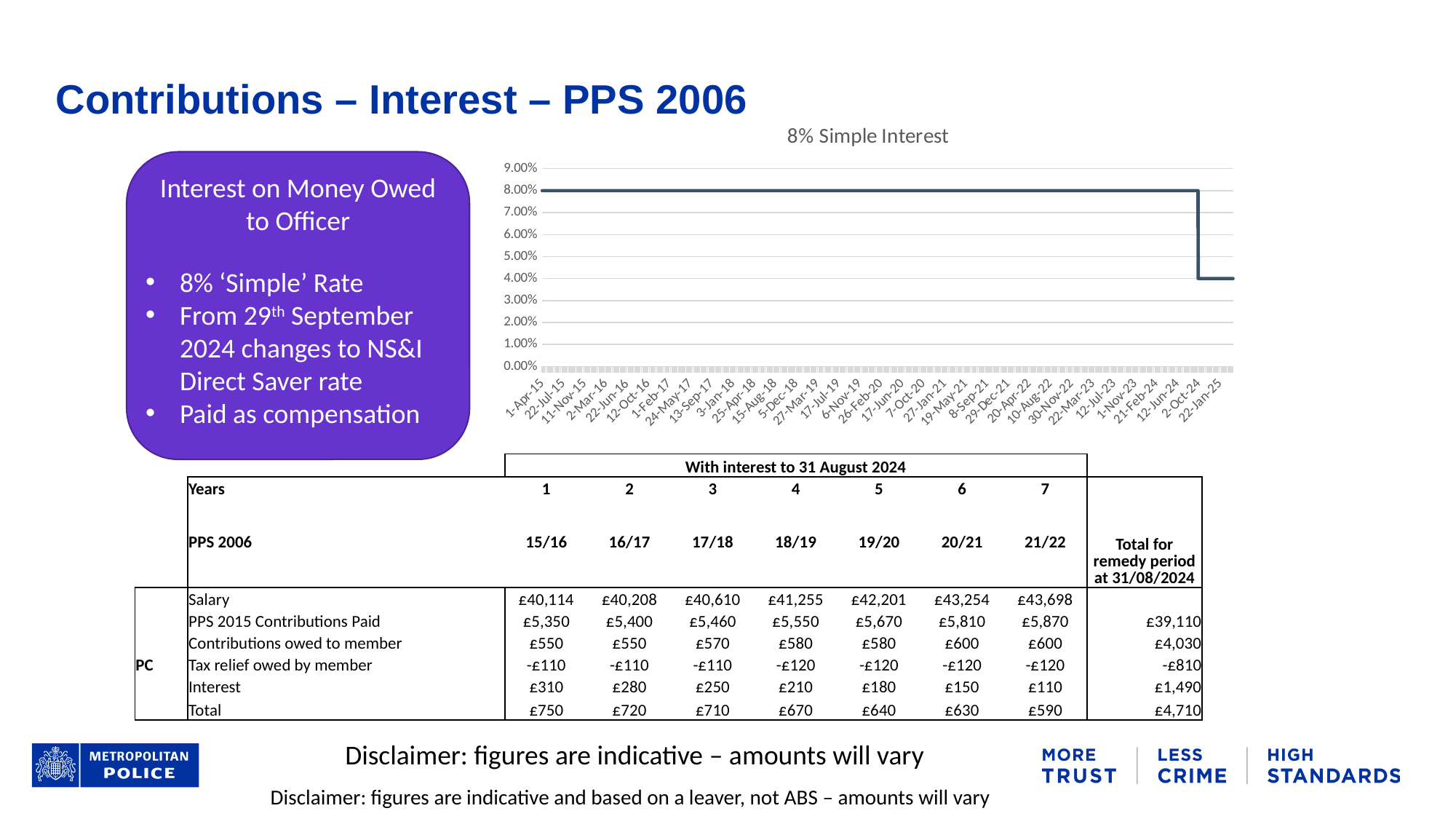
Is the value of the line at 17-Jun-20 greater or less than 7.00%? greater What interest rate does the line show at 1-Apr-15? 8.00% What kind of chart is shown on the slide? line chart Is the value of the line at 22-Jan-25 greater or less than 5.00%? less What is the highest value shown on the y axis? 9.00% Which is larger, the value of the line at 1-Feb-17 or at 22-Jan-25? 1-Feb-17 What is the title of the chart? 8% Simple Interest What is the first date label on the x axis? 1-Apr-15 Is the value of the line at 22-Jan-25 greater or less than 3.00%? greater Does the plotted interest rate rise or fall along the x axis? fall